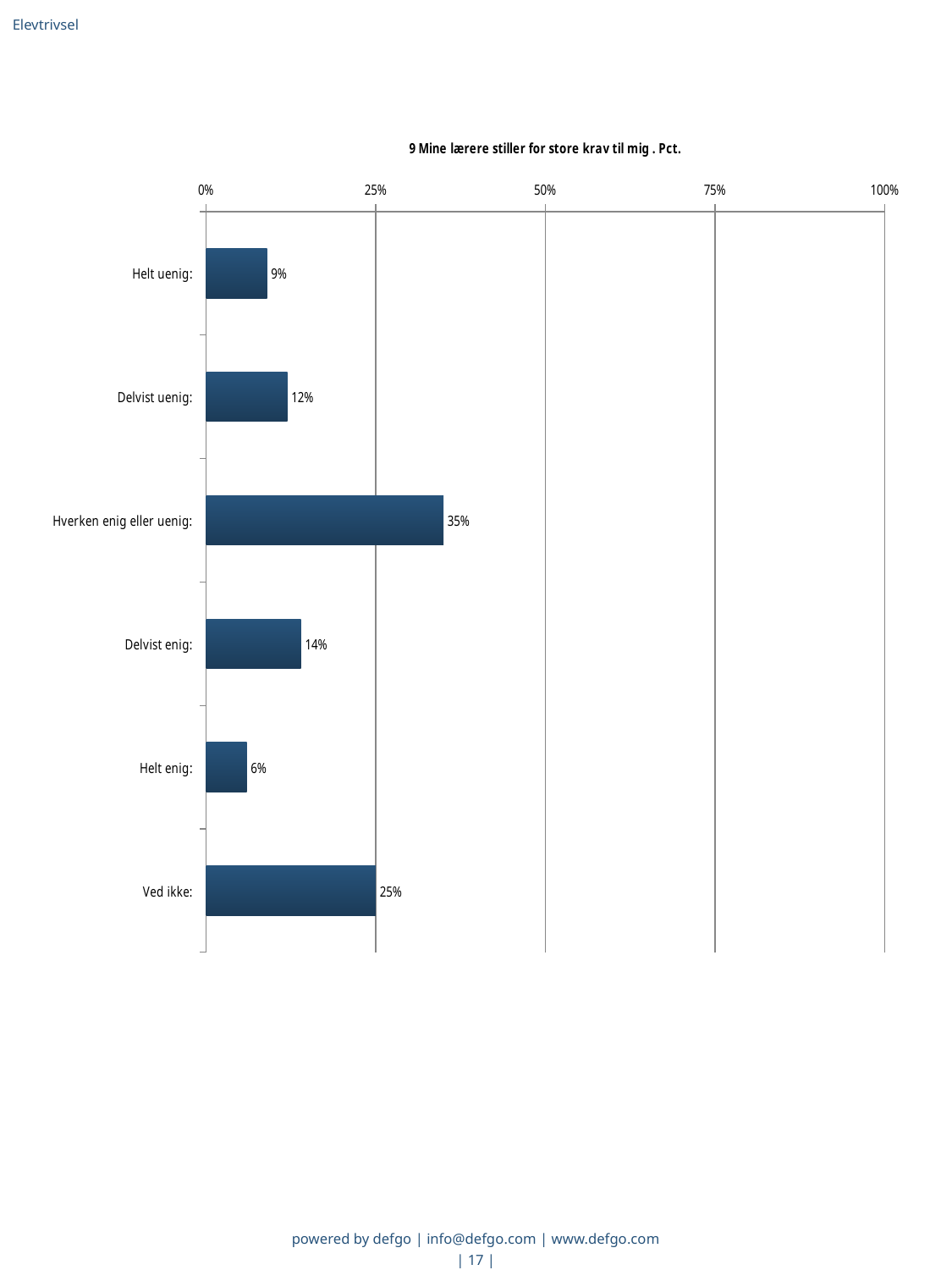
What kind of chart is shown on the slide? Bar chart Which category has the lowest value? Helt enig Which category has the highest value? Hverken enig eller uenig What is the value for "Helt enig"? 6% What is the title of the chart? 9 Mine lærere stiller for store krav til mig . Pct. Is the value for "Hverken enig eller uenig" greater or less than 25%? greater What is the value for "Hverken enig eller uenig"? 35% What is the difference between the values for "Hverken enig eller uenig" and "Ved ikke"? 10% Which is larger, the value for "Delvist enig" or the value for "Helt uenig"? Delvist enig What is the value for "Delvist uenig"? 12% How many categories are shown in the chart? 6 What is the value for "Ved ikke"? 25%